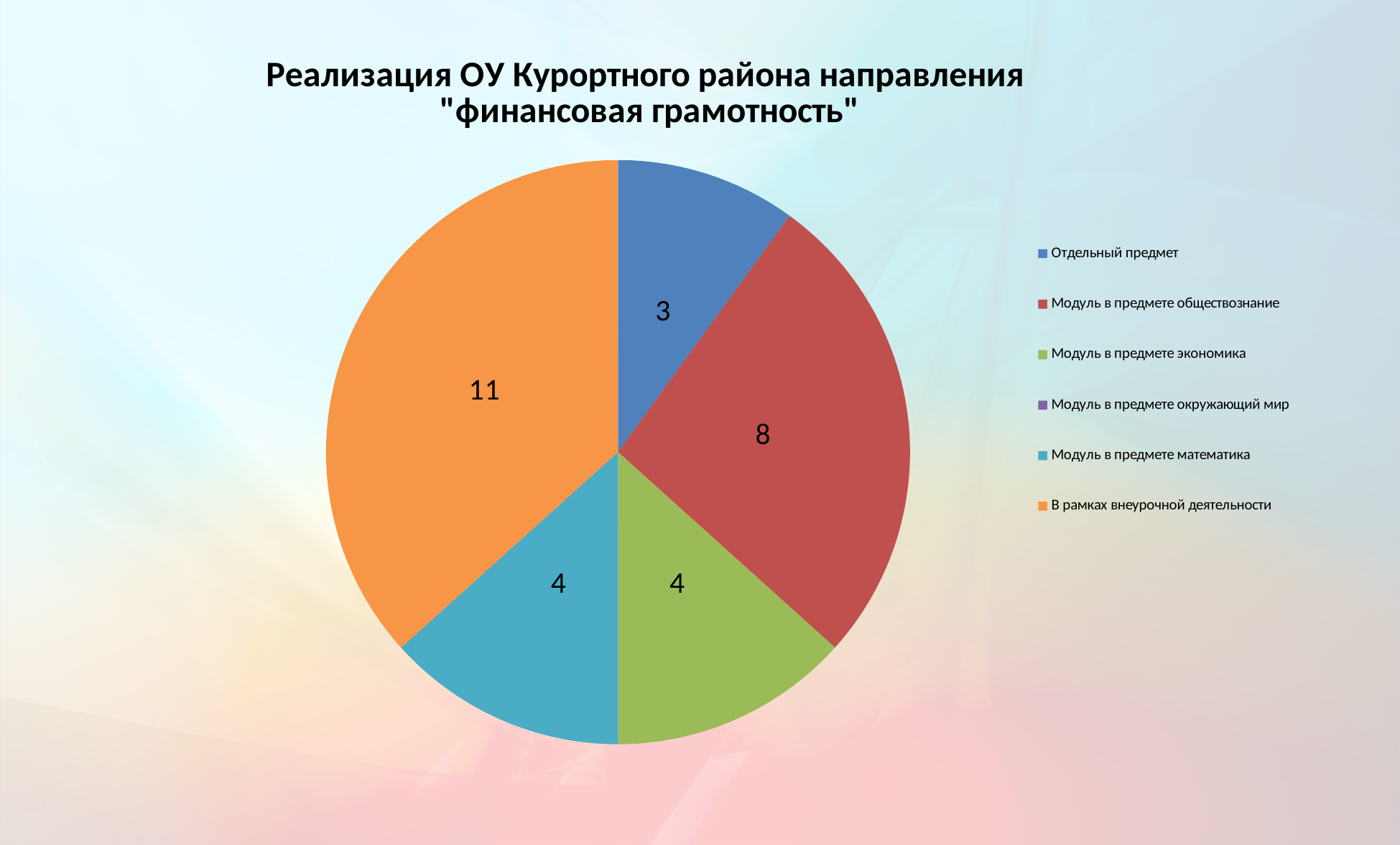
Which labelled slice has the smallest value? Отдельный предмет What is the value for "Отдельный предмет"? 3 What is the value for "Модуль в предмете обществознание"? 8 How many entries does the legend list? 6 What is the value for "В рамках внеурочной деятельности"? 11 Which category has the largest slice of the pie? В рамках внеурочной деятельности What kind of chart is shown on the slide? Pie chart How many slices with data labels are visible in the pie? 5 What colour is the slice for "Модуль в предмете экономика"? Green Which is larger: the value for "Модуль в предмете обществознание" or the value for "Модуль в предмете экономика"? Модуль в предмете обществознание What is the value for "Модуль в предмете математика"? 4 What is the difference between the values for "В рамках внеурочной деятельности" and "Модуль в предмете обществознание"? 3